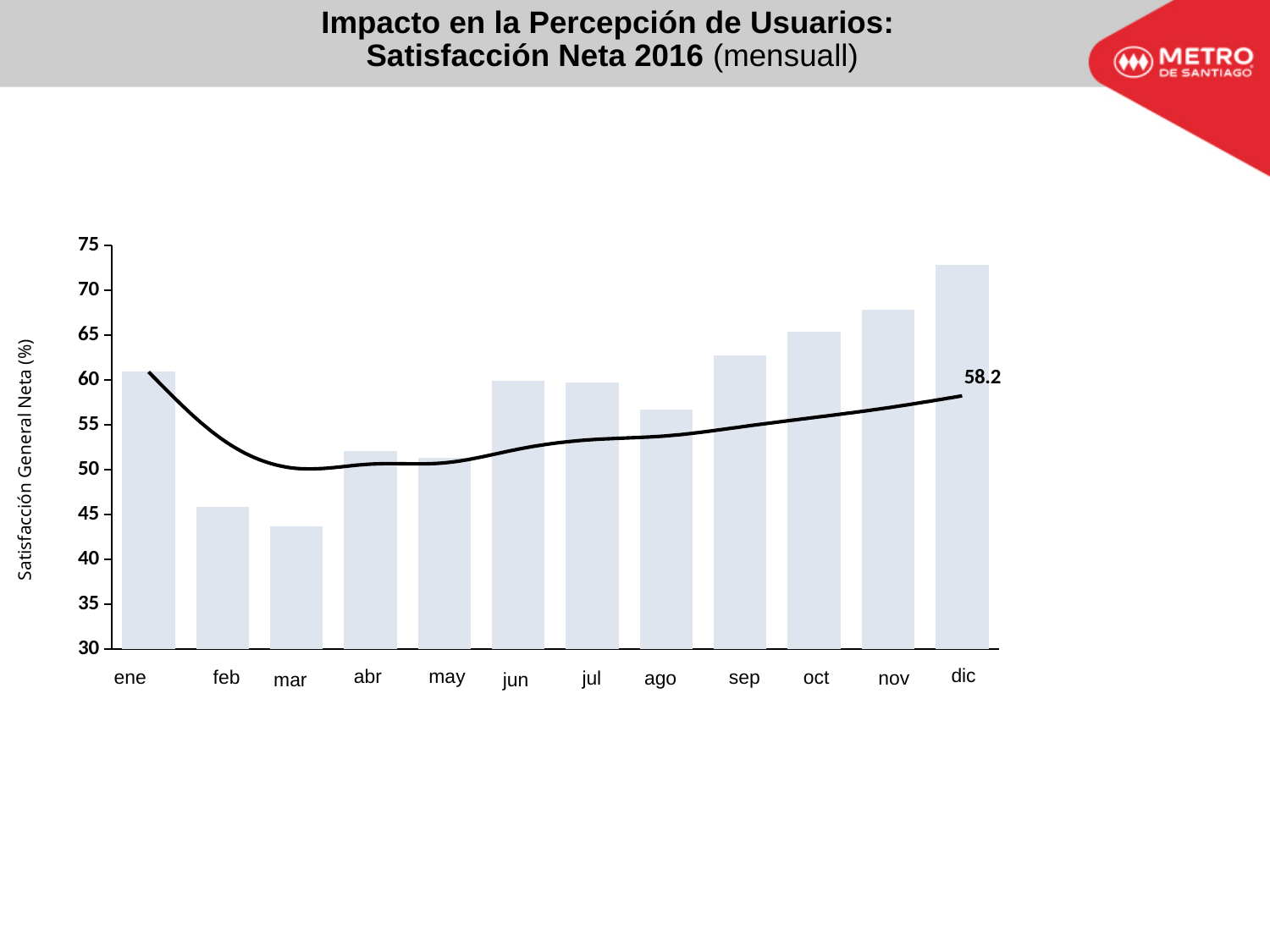
Is the bar for dic greater or less than 70? greater What value is printed at the end of the trend line in December? 58.2 How many months are plotted along the x axis? 12 Which month has the lowest bar? mar Which month has the highest bar? dic Which is larger, the bar for ene or the bar for feb? ene What is the label on the vertical axis? Satisfacción General Neta (%) From sep to dic, do the bars rise or fall? rise Is the bar for ago greater or less than 60? less What kind of chart is shown on the slide? bar chart with a trend line Is the bar for feb greater or less than 50? less